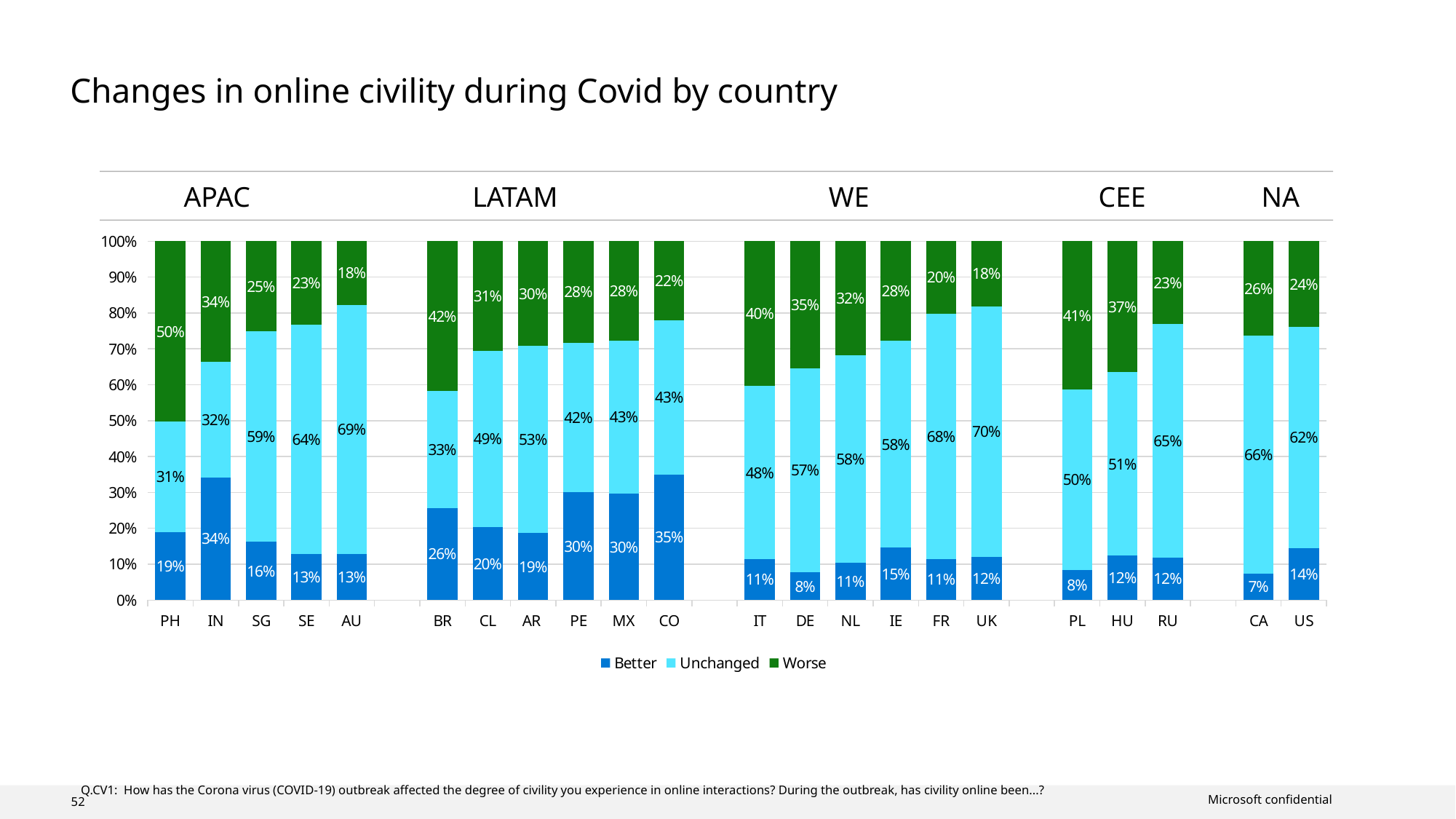
Which country has the highest Worse percentage? PH How many countries are shown on the x axis? 22 What is the difference between the Worse value for PH and the Worse value for AU? 32 percentage points How many series does the legend list? 3 Which country has the highest Unchanged percentage? UK What is the Unchanged value for UK? 70% What is the Worse value for DE? 35% Which country has the lowest Better percentage? CA What kind of chart is shown on the slide? Stacked bar chart What is the Better value for CO? 35% Which has a larger Worse value, BR or CL? BR What percentage of respondents in PH said online civility got worse? 50%